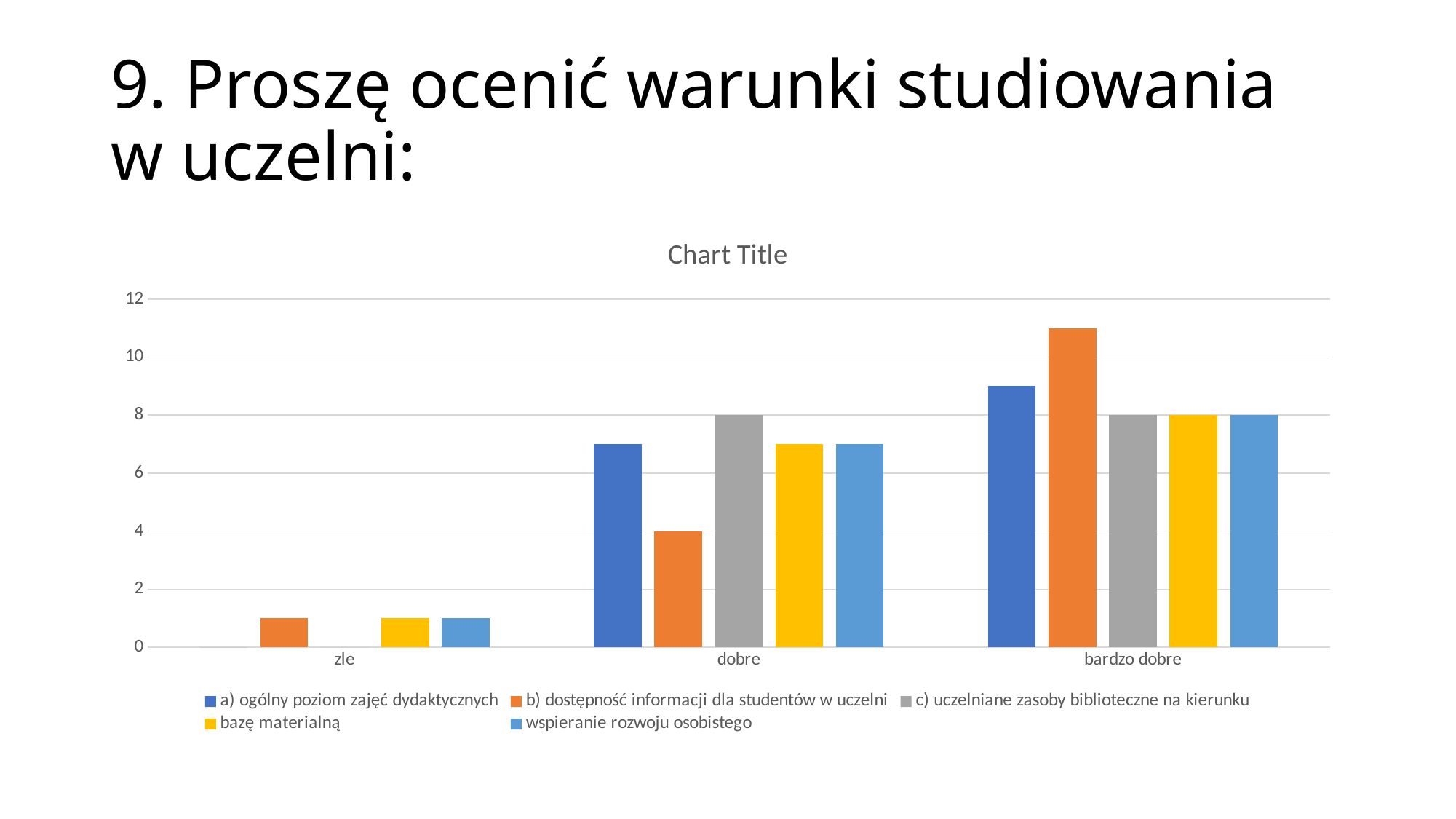
How many series does the legend list? 5 What is the value for 'c) uczelniane zasoby biblioteczne na kierunku' in the 'dobre' category? 8 What is the difference between 'c) uczelniane zasoby biblioteczne na kierunku' and 'b) dostępność informacji dla studentów w uczelni' in the 'dobre' category? 4 What is the value for 'b) dostępność informacji dla studentów w uczelni' in the 'dobre' category? 4 What is the value for 'bazę materialną' in the 'bardzo dobre' category? 8 Is the value for 'a) ogólny poziom zajęć dydaktycznych' in the 'dobre' category greater or less than 8? less Which series has the lowest value in the 'dobre' category? b) dostępność informacji dla studentów w uczelni Is the value for 'b) dostępność informacji dla studentów w uczelni' in the 'bardzo dobre' category greater or less than 10? greater What kind of chart is shown on the slide? bar chart Which is larger for 'b) dostępność informacji dla studentów w uczelni': the value for 'dobre' or for 'bardzo dobre'? bardzo dobre Which series has the highest value in the 'bardzo dobre' category? b) dostępność informacji dla studentów w uczelni How many categories are shown on the x axis? 3